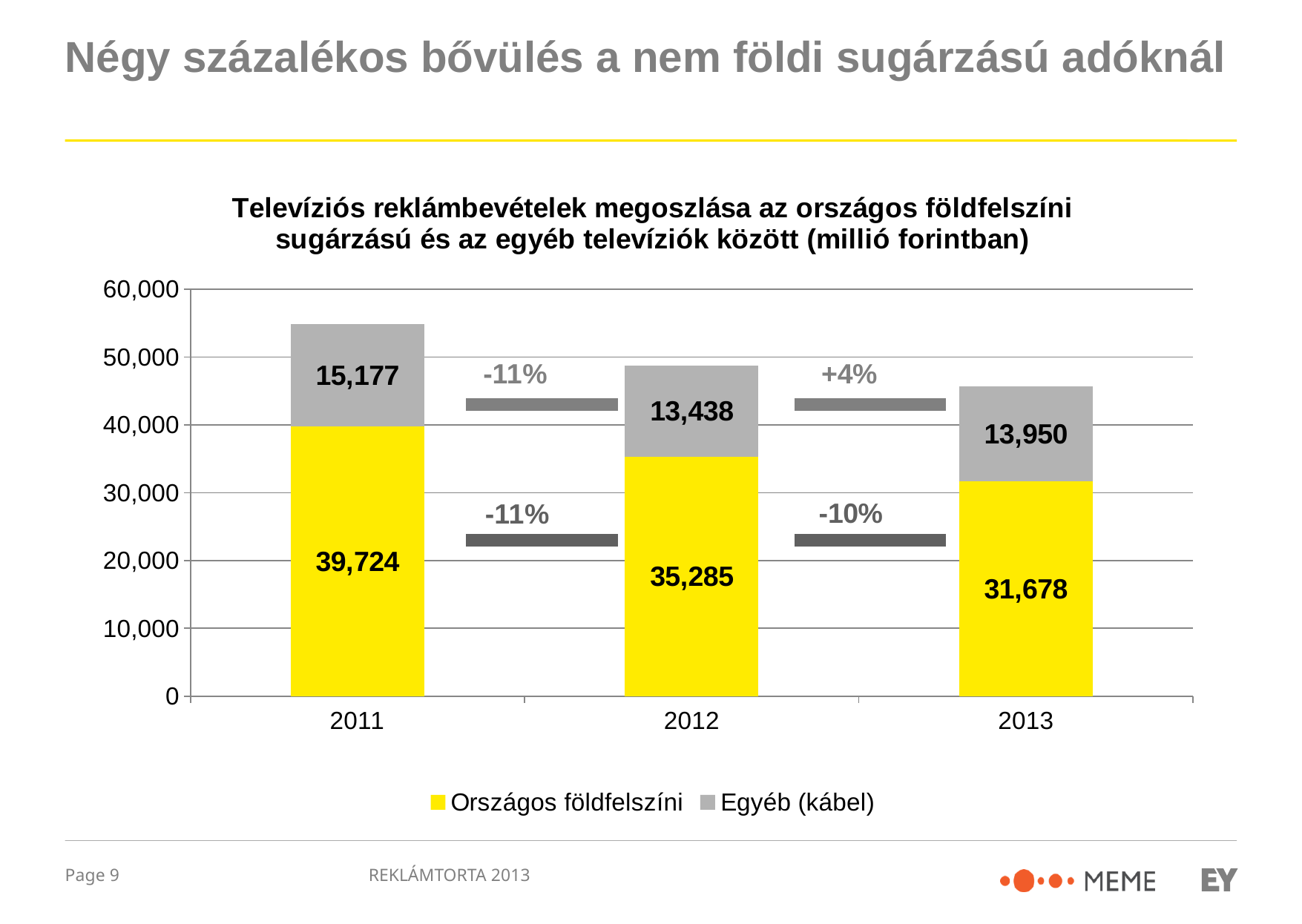
What is the value for Egyéb (kábel) in 2013? 13,950 What is the value for Országos földfelszíni in 2013? 31,678 Do the Országos földfelszíni values rise or fall from 2011 to 2013? Fall In which year is the Egyéb (kábel) value the highest? 2011 Which is larger: the Egyéb (kábel) value for 2012 or for 2013? 2013 What kind of chart is shown on the slide? Stacked bar chart What is the value for Országos földfelszíni in 2011? 39,724 How many years are shown on the x axis? 3 How many series does the legend list? 2 In which year is the Országos földfelszíni value the lowest? 2013 What is the difference between the Országos földfelszíni values for 2011 and 2012? 4,439 What is the total of the stacked bar for 2012? 48,723